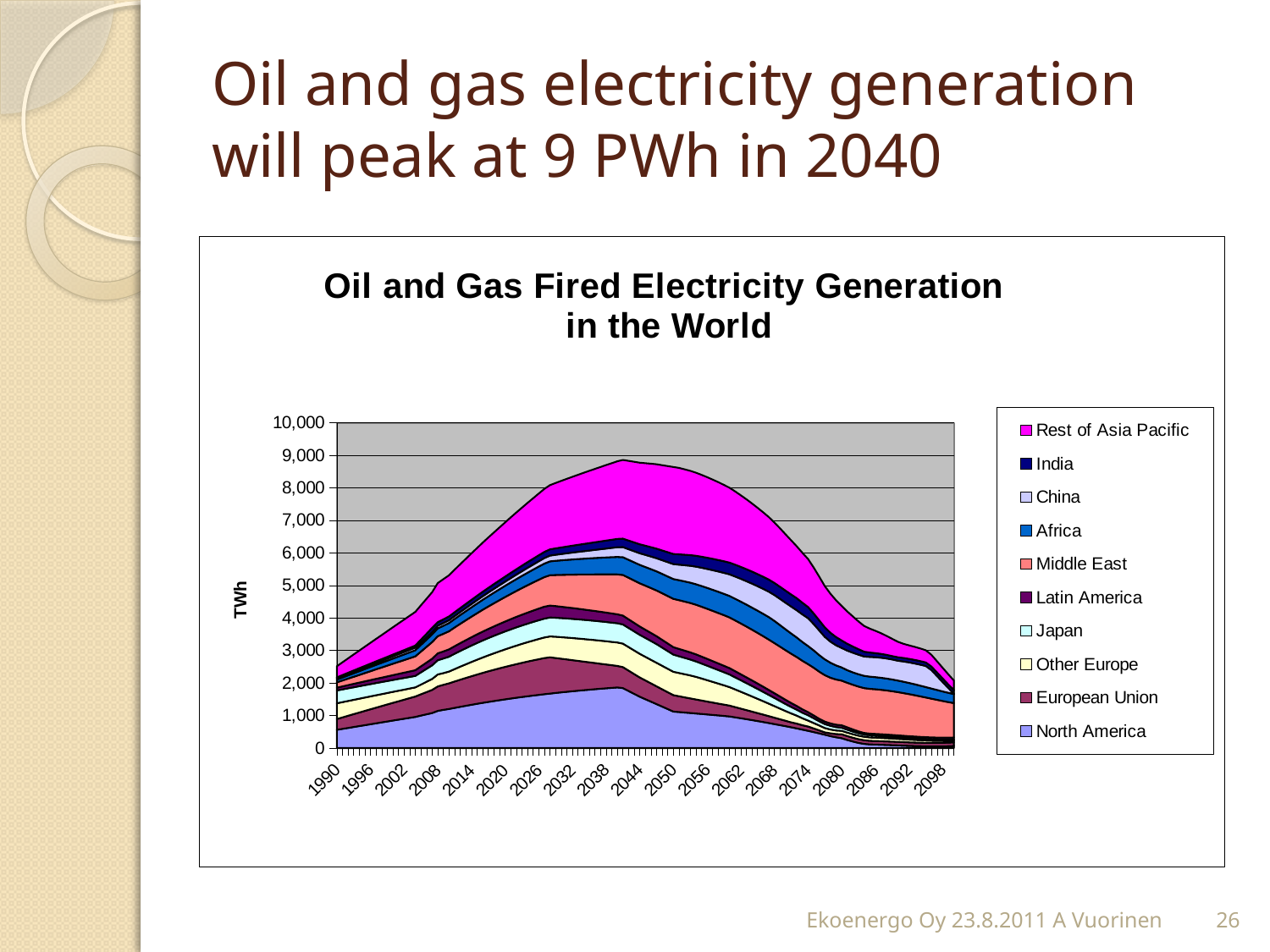
Is the total oil and gas fired electricity generation in 1990 greater or less than 3,000 TWh? less What is the title of the chart? Oil and Gas Fired Electricity Generation in the World What kind of chart is shown on the slide? Stacked area chart How many year labels are shown on the horizontal axis of the chart? 19 Which year is the total oil and gas fired electricity generation higher, 2044 or 2098? 2044 Does the total oil and gas fired electricity generation rise or fall between 2044 and 2098? fall How many series does the legend of the chart list? 10 What unit is shown on the vertical axis of the chart? TWh Does the total oil and gas fired electricity generation rise or fall between 1990 and 2038? rise Is the total oil and gas fired electricity generation in 2044 greater or less than 8,000 TWh? greater Is the total oil and gas fired electricity generation in 2074 greater or less than 5,000 TWh? greater